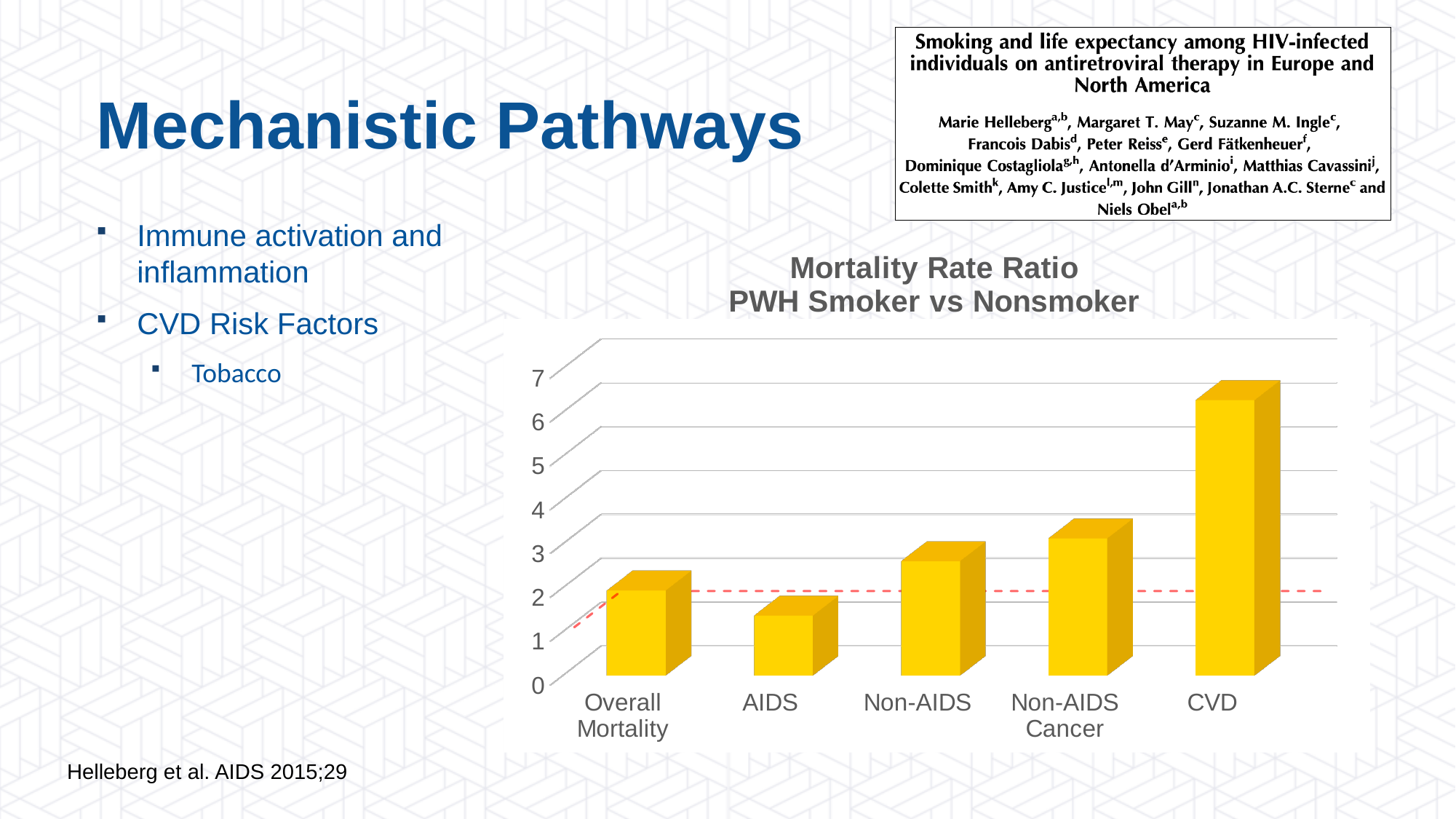
Is the value for AIDS greater or less than 2? less At what value on the y axis is the red dashed horizontal line drawn? 2 Is the value for CVD greater or less than 5? greater Which category has the lowest mortality rate ratio? AIDS Which category has the highest mortality rate ratio? CVD How many categories are shown on the x axis of the chart? 5 What kind of chart is shown on the slide? Bar chart Do the values rise or fall from Non-AIDS to CVD along the x axis? rise Which is larger, the value for CVD or the value for AIDS? CVD What is the title of the chart? Mortality Rate Ratio PWH Smoker vs Nonsmoker Which is larger, the value for Non-AIDS Cancer or the value for Non-AIDS? Non-AIDS Cancer